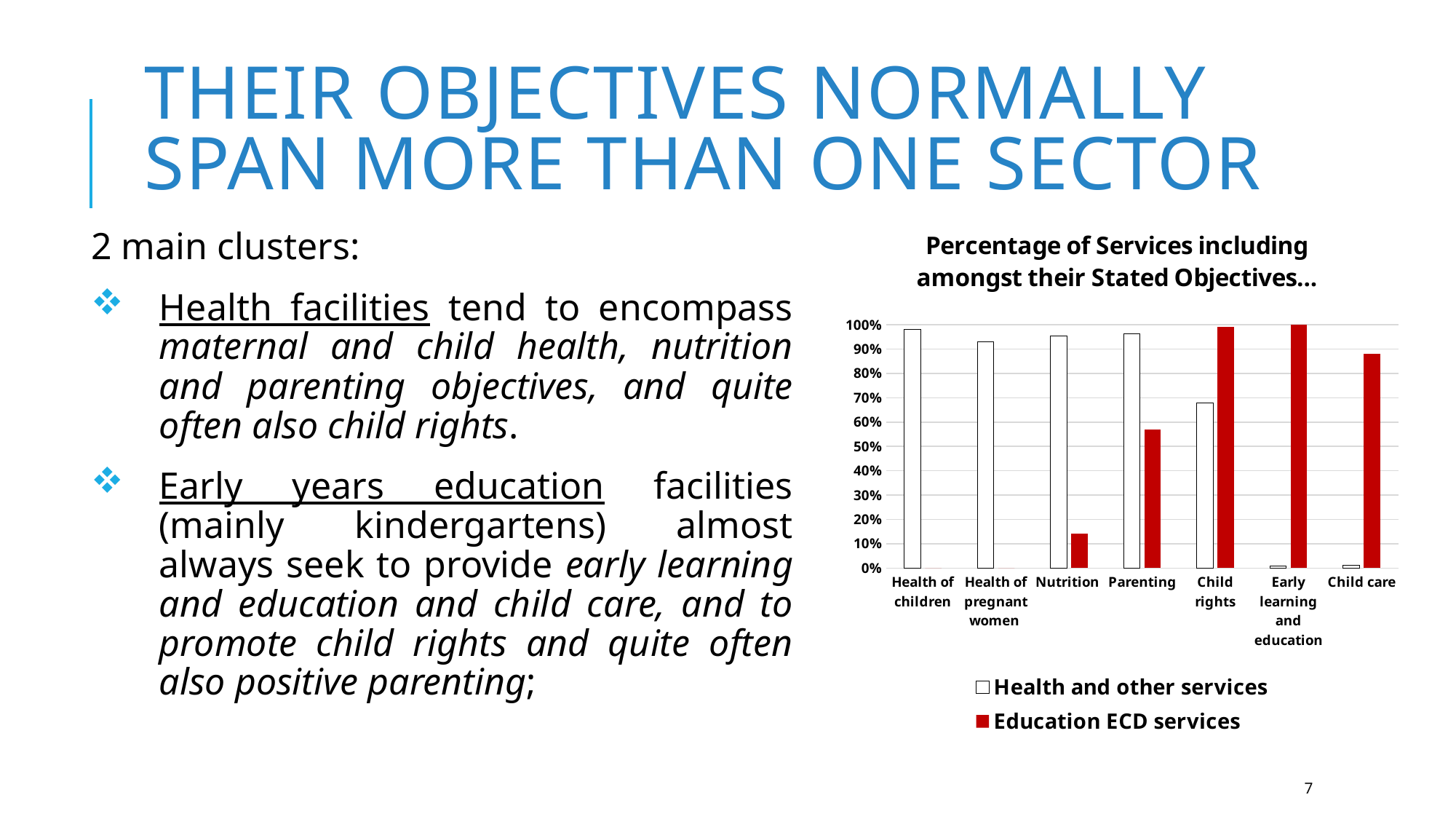
Which category has the highest value for Education ECD services? Early learning and education What colour are the bars for the Education ECD services series? red What kind of chart is shown on the slide? bar chart Is the value for Parenting in the Education ECD services series greater or less than 50%? greater What is the title of the chart? Percentage of Services including amongst their Stated Objectives... Is the value for Child rights in the Health and other services series greater or less than 60%? greater How many series does the legend list? 2 For Health of children, which series has the larger value: Health and other services or Education ECD services? Health and other services Is the value for Nutrition in the Education ECD services series greater or less than 20%? less How many categories are shown on the x axis of the chart? 7 For Child care, which series has the larger value: Health and other services or Education ECD services? Education ECD services